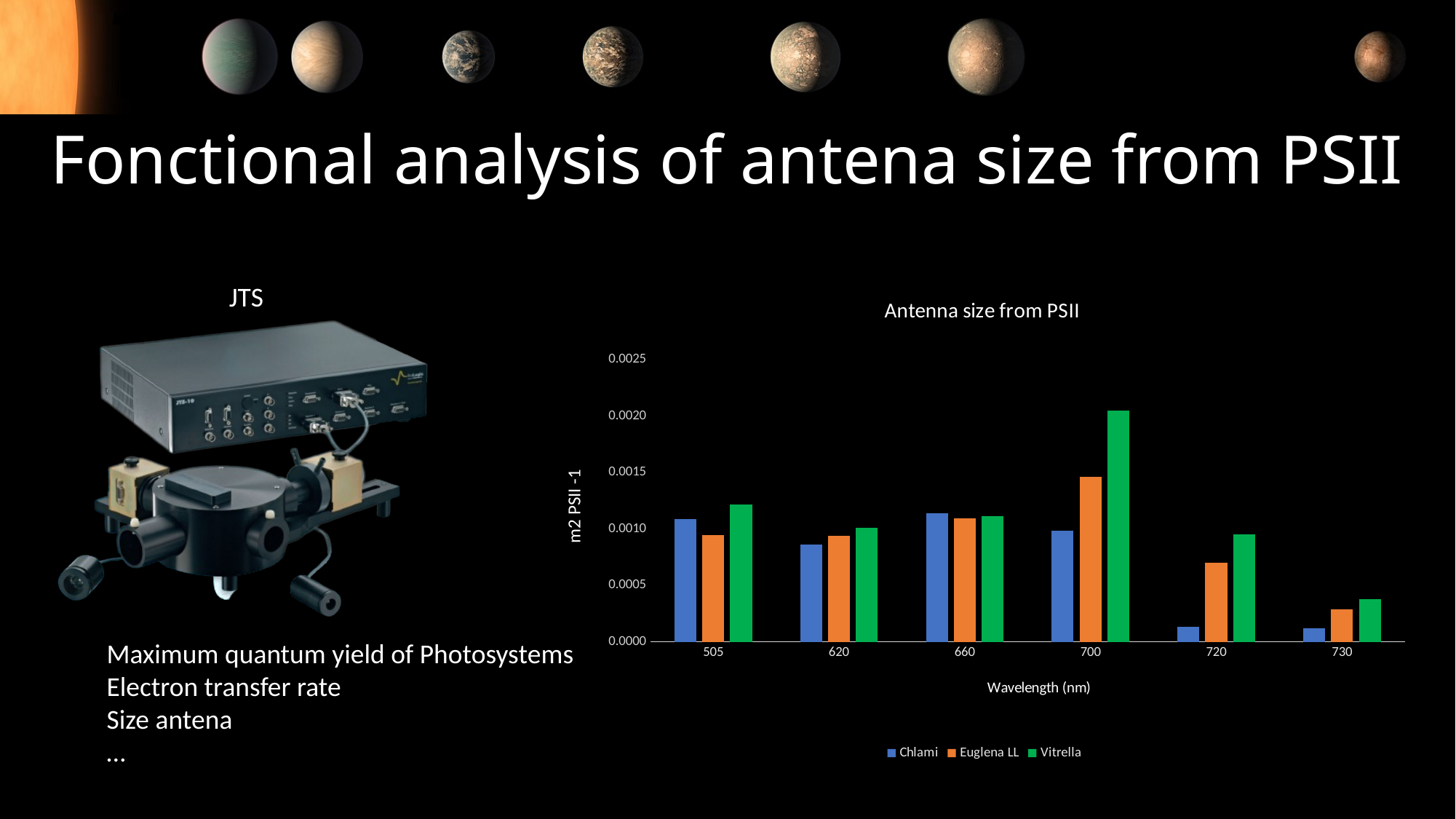
Is the value for Vitrella at 700 nm greater or less than 0.0015? greater Is the value for Chlami at 720 nm greater or less than 0.0005? less At 720 nm, which is larger: Chlami or Euglena LL? Euglena LL Is the value for Euglena LL at 720 nm greater or less than 0.0005? greater How many wavelength categories are shown on the x axis of the chart? 6 At which wavelength is the Vitrella bar lowest? 730 How many series does the legend of the chart list? 3 What kind of chart is shown on the slide? bar chart What is the title of the x axis of the chart? Wavelength (nm) Do the Chlami values rise or fall from 700 nm to 730 nm? fall At which wavelength is the Vitrella bar highest? 700